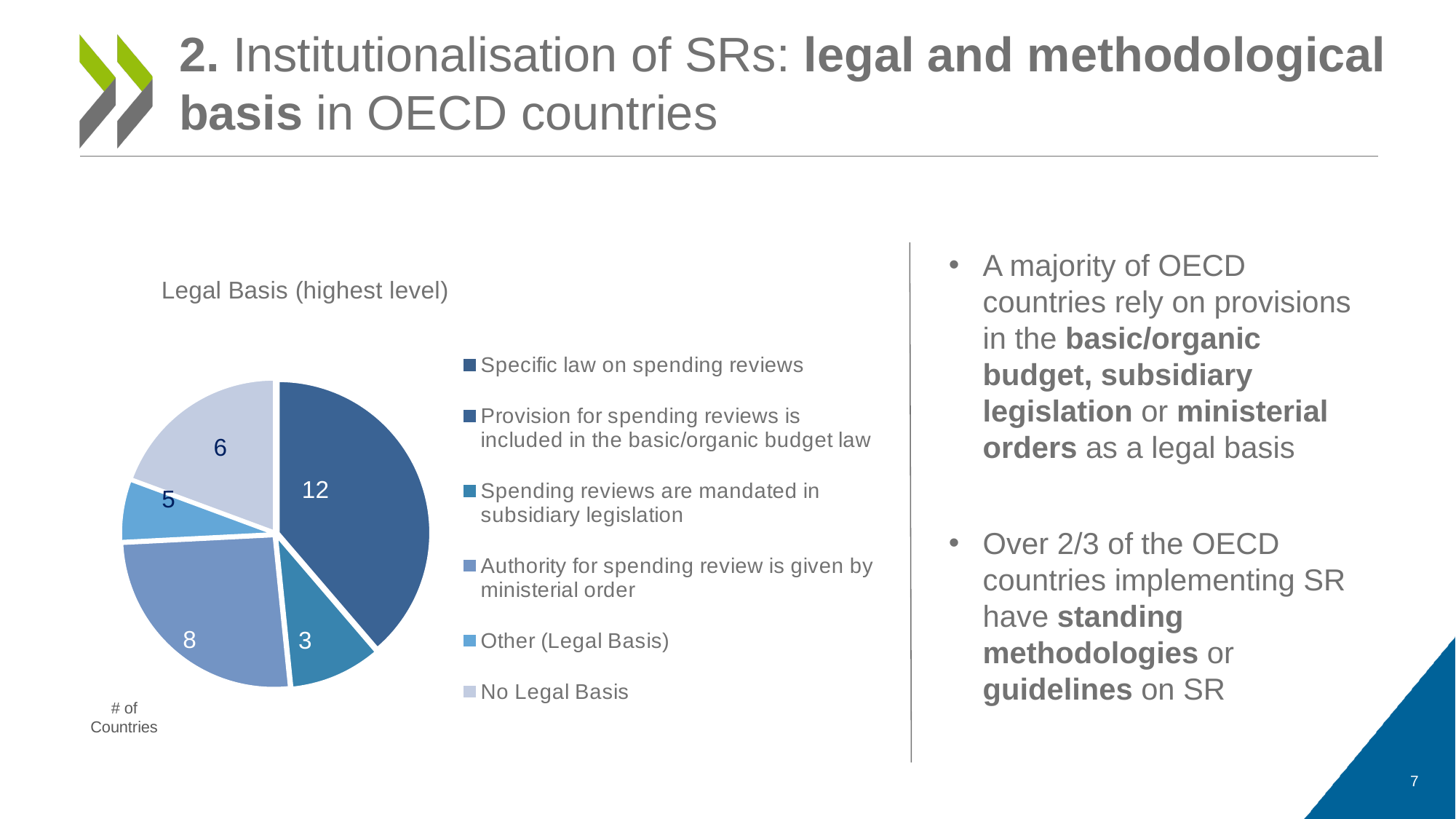
How many countries have spending reviews mandated in subsidiary legislation? 3 How many entries does the chart legend list? 6 What is the title of the chart? Legal Basis (highest level) What is the difference between the number of countries with a provision in the basic/organic budget law and the number with authority given by ministerial order? 4 How many countries fall under 'Other (Legal Basis)'? 5 Which is larger: the number of countries with no legal basis or the number under 'Other (Legal Basis)'? No Legal Basis How many countries have no legal basis? 6 How many countries have authority for spending review given by ministerial order? 8 How many countries have a provision for spending reviews included in the basic/organic budget law? 12 What type of chart is shown on the slide? Pie chart Which legal basis category has the largest slice of the pie? Provision for spending reviews is included in the basic/organic budget law